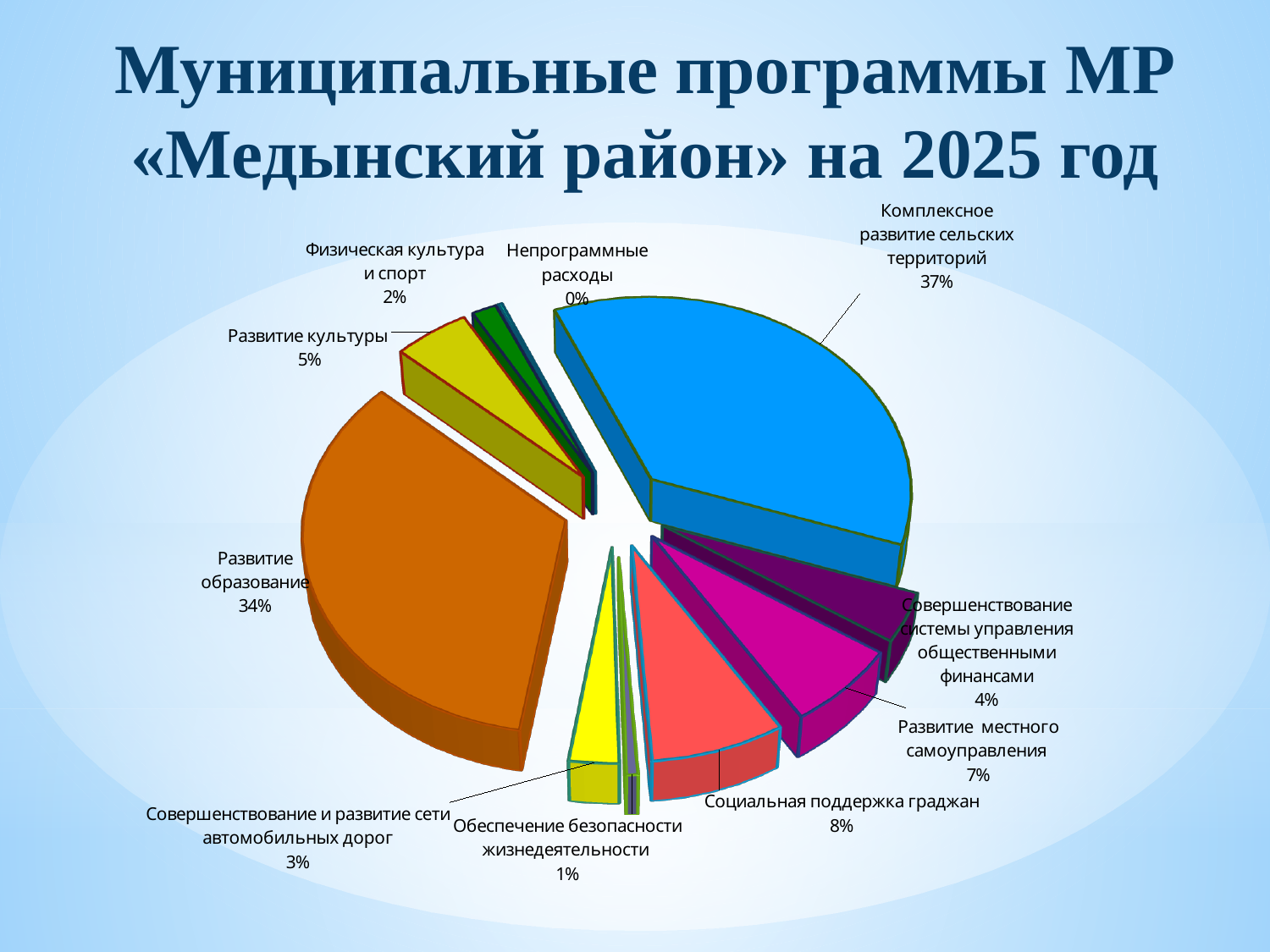
What is the value shown for «Социальная поддержка граждан»? 8% What is the value shown for «Развитие образование»? 34% What kind of chart is shown on the slide? pie chart What is the value shown for «Совершенствование и развитие сети автомобильных дорог»? 3% What is the title of the slide? Муниципальные программы МР «Медынский район» на 2025 год Which category has the largest share of the pie? Комплексное развитие сельских территорий What is the value shown for «Развитие местного самоуправления»? 7% Which is larger: «Развитие культуры» or «Физическая культура и спорт»? Развитие культуры What is the difference in percentage points between «Комплексное развитие сельских территорий» and «Развитие образование»? 3 percentage points How many categories are shown in the pie chart? 10 What share of the pie does «Комплексное развитие сельских территорий» have? 37% Which category has the smallest share of the pie? Непрограммные расходы